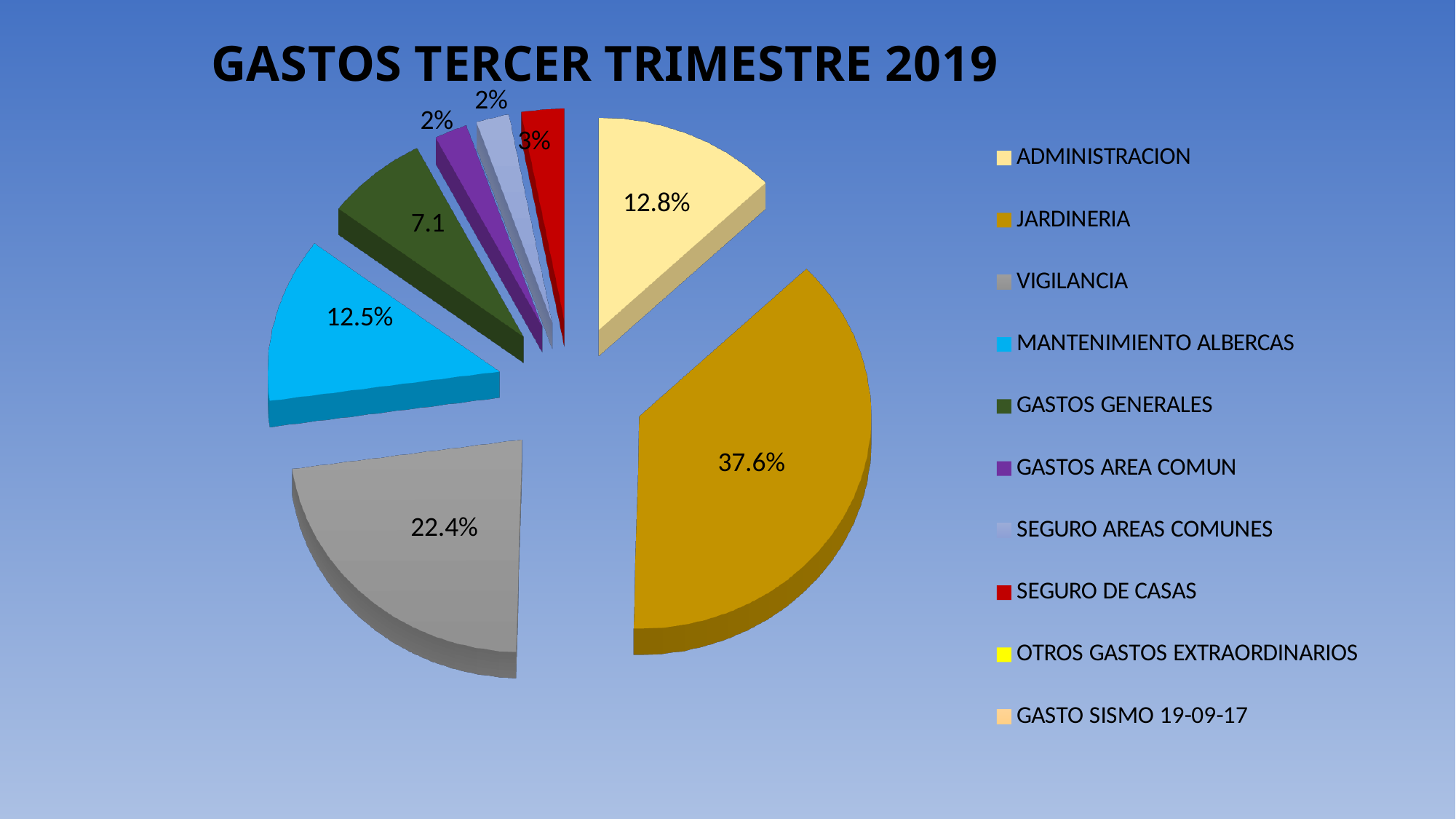
What is the value shown for VIGILANCIA? 22.4% Which is larger, the value for ADMINISTRACION or the value for MANTENIMIENTO ALBERCAS? ADMINISTRACION What is the value shown for MANTENIMIENTO ALBERCAS? 12.5% What is the title of the chart? GASTOS TERCER TRIMESTRE 2019 What is the value shown for GASTOS GENERALES? 7.1 Which category has the largest slice of the pie? JARDINERIA What is the difference between the JARDINERIA and VIGILANCIA percentages? 15.2 percentage points What percentage of the pie does JARDINERIA represent? 37.6% What is the value shown for SEGURO DE CASAS? 3% What is the value shown for ADMINISTRACION? 12.8% What type of chart is shown on the slide? pie chart How many categories are listed in the legend? 10